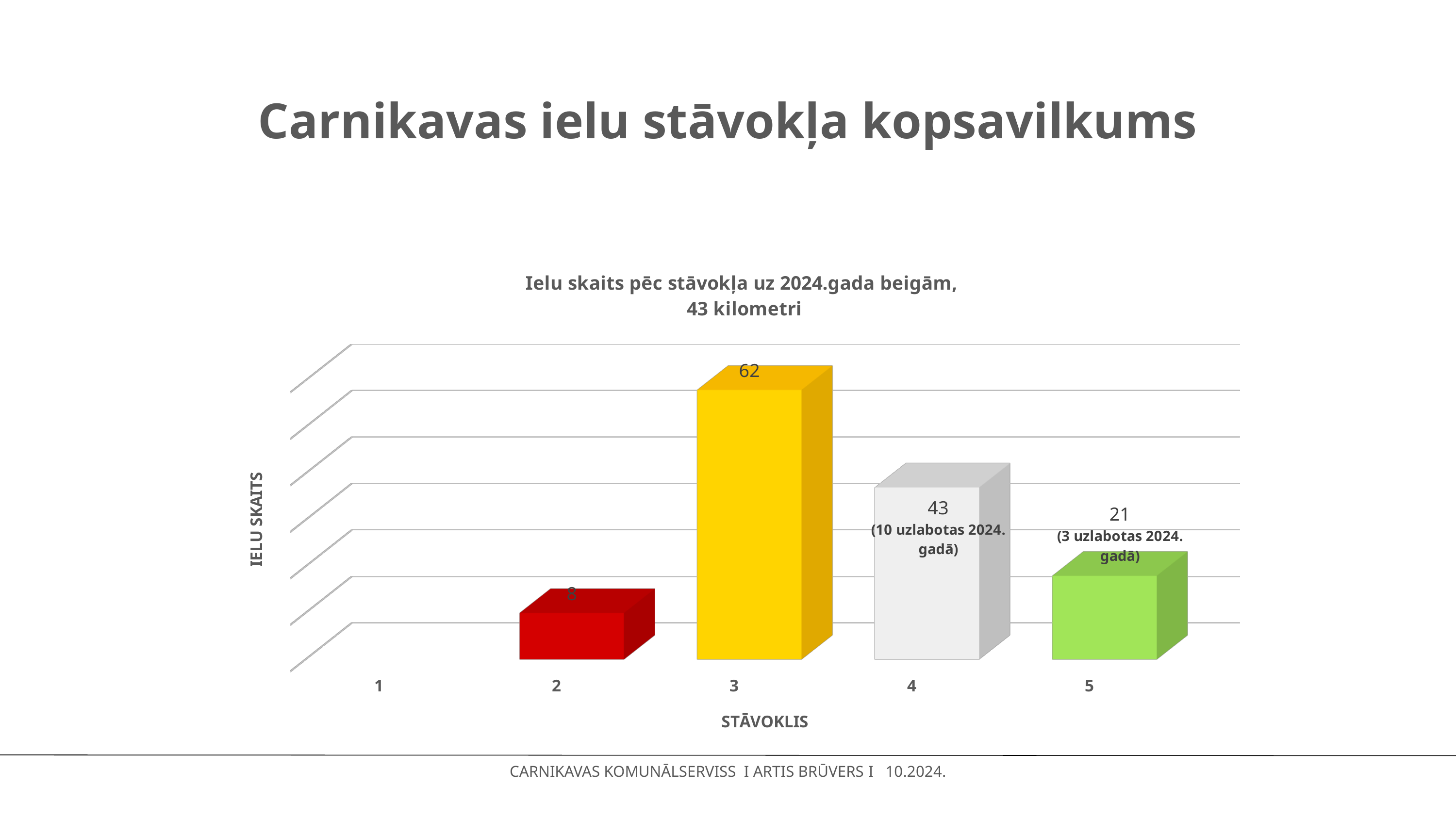
What is the value for category 2 (STĀVOKLIS 2)? 8 What is the value for category 4 (STĀVOKLIS 4)? 43 What is the title of the x axis? STĀVOKLIS Which is larger, the value for category 2 or the value for category 5? category 5 What is the difference between the values for category 4 and category 5? 22 How many categories are shown on the x axis? 5 What is the value for category 3 (STĀVOKLIS 3)? 62 Which category has the highest value? 3 What is the value for category 5 (STĀVOKLIS 5)? 21 What is the difference between the values for category 3 and category 4? 19 What kind of chart is shown on the slide? bar chart Which category with a plotted bar has the lowest value? 2